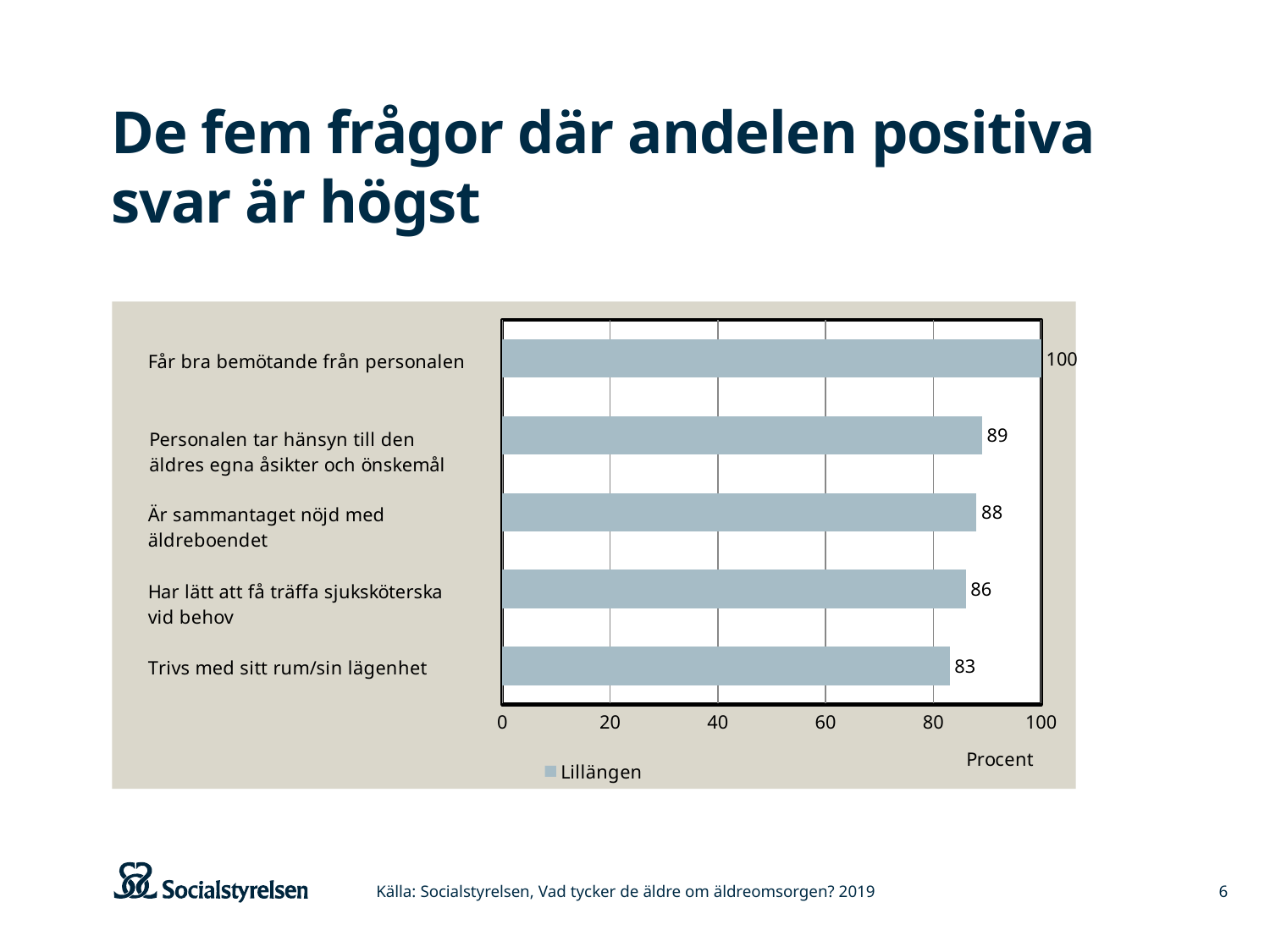
What kind of chart is shown on the slide? bar chart What is the value for "Har lätt att få träffa sjuksköterska vid behov"? 86 Which is larger: the value for "Personalen tar hänsyn till den äldres egna åsikter och önskemål" or for "Är sammantaget nöjd med äldreboendet"? Personalen tar hänsyn till den äldres egna åsikter och önskemål What is the name of the series shown in the legend? Lillängen How many series does the legend list? 1 Is the value for "Är sammantaget nöjd med äldreboendet" greater or less than 80? greater Which category has the lowest value? Trivs med sitt rum/sin lägenhet What is the value for "Trivs med sitt rum/sin lägenhet"? 83 What is the value for "Får bra bemötande från personalen"? 100 How many categories are shown in the chart? 5 Which category has the highest value? Får bra bemötande från personalen What is the difference between the values for "Får bra bemötande från personalen" and "Trivs med sitt rum/sin lägenhet"? 17